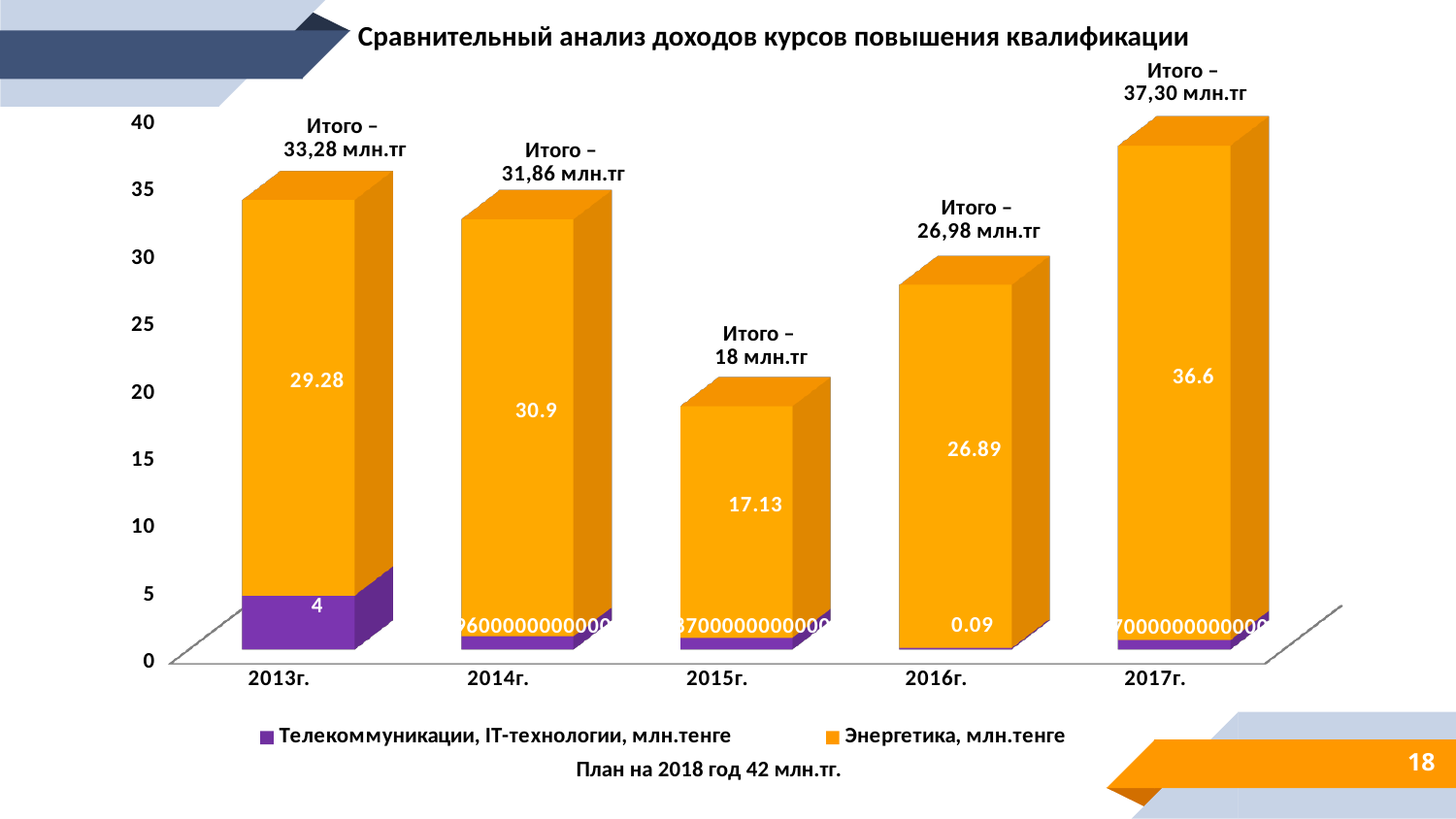
Which is larger, the Энергетика value for 2014г. or for 2016г.? 2014г. What type of chart is shown on the slide? bar chart What total (Итого) is shown for 2016г.? 26,98 млн.тг What is the value for Телекоммуникации, IT-технологии in 2016г.? 0.09 Which year has the lowest value for Энергетика? 2015г. How many series does the legend list? 2 Which year has the highest value for Энергетика? 2017г. What is the value for Энергетика in 2015г.? 17.13 What is the value for Телекоммуникации, IT-технологии in 2013г.? 4 What is the difference between the Энергетика values for 2017г. and 2015г.? 19.47 What is the value for Энергетика in 2017г.? 36.6 How many years are shown on the x axis? 5